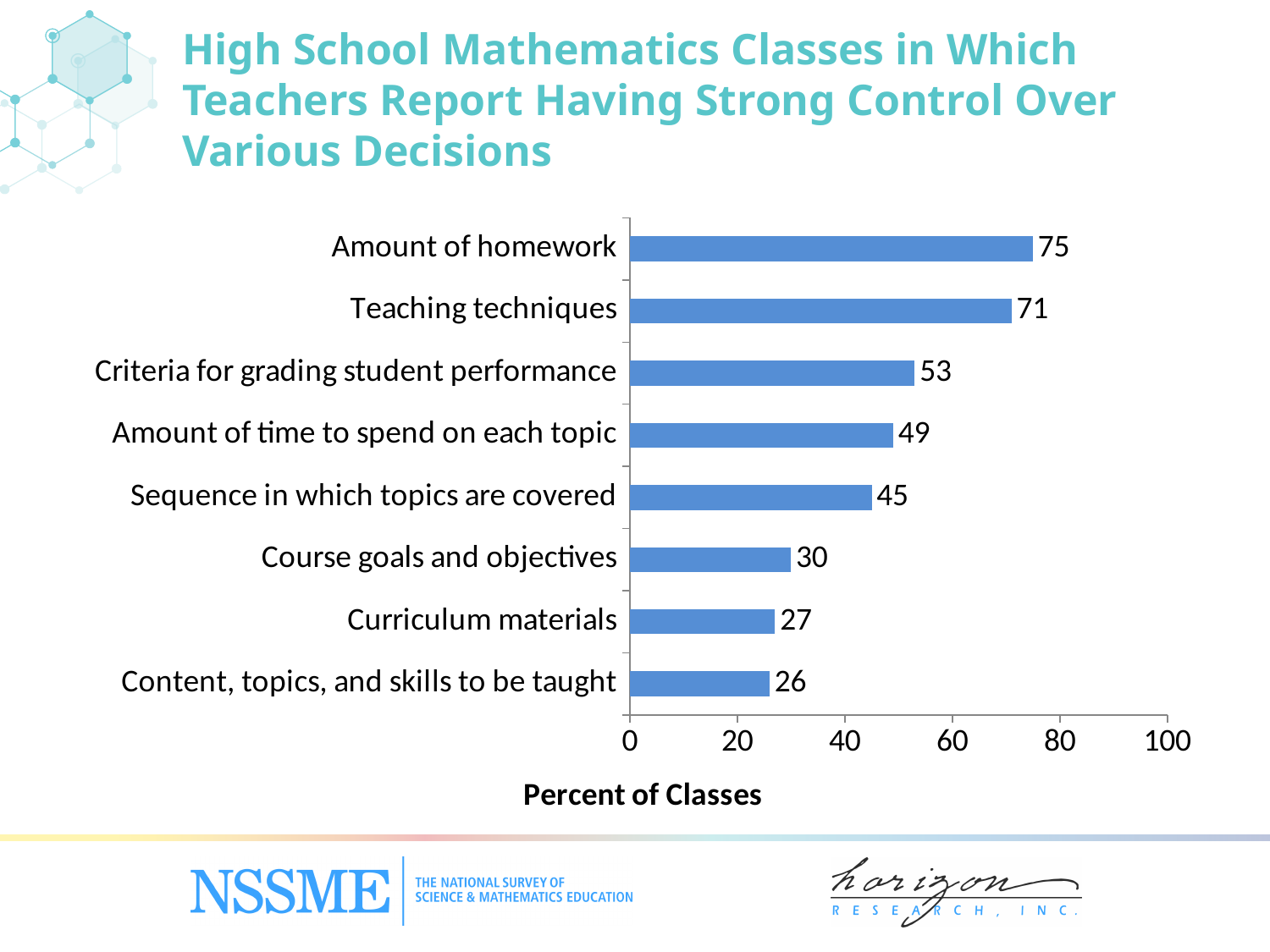
How many categories are shown in the chart? 8 What is the highest tick value shown on the horizontal axis? 100 What is the value for Amount of homework? 75 Which is larger, the value for Amount of time to spend on each topic or the value for Course goals and objectives? Amount of time to spend on each topic Which category has the lowest value? Content, topics, and skills to be taught What is the difference between the values for Teaching techniques and Criteria for grading student performance? 18 What kind of chart is shown on the slide? bar chart What is the label of the horizontal axis? Percent of Classes Which category has the highest value? Amount of homework What is the value for Curriculum materials? 27 Is the value for Criteria for grading student performance greater or less than 40? greater What is the value for Sequence in which topics are covered? 45